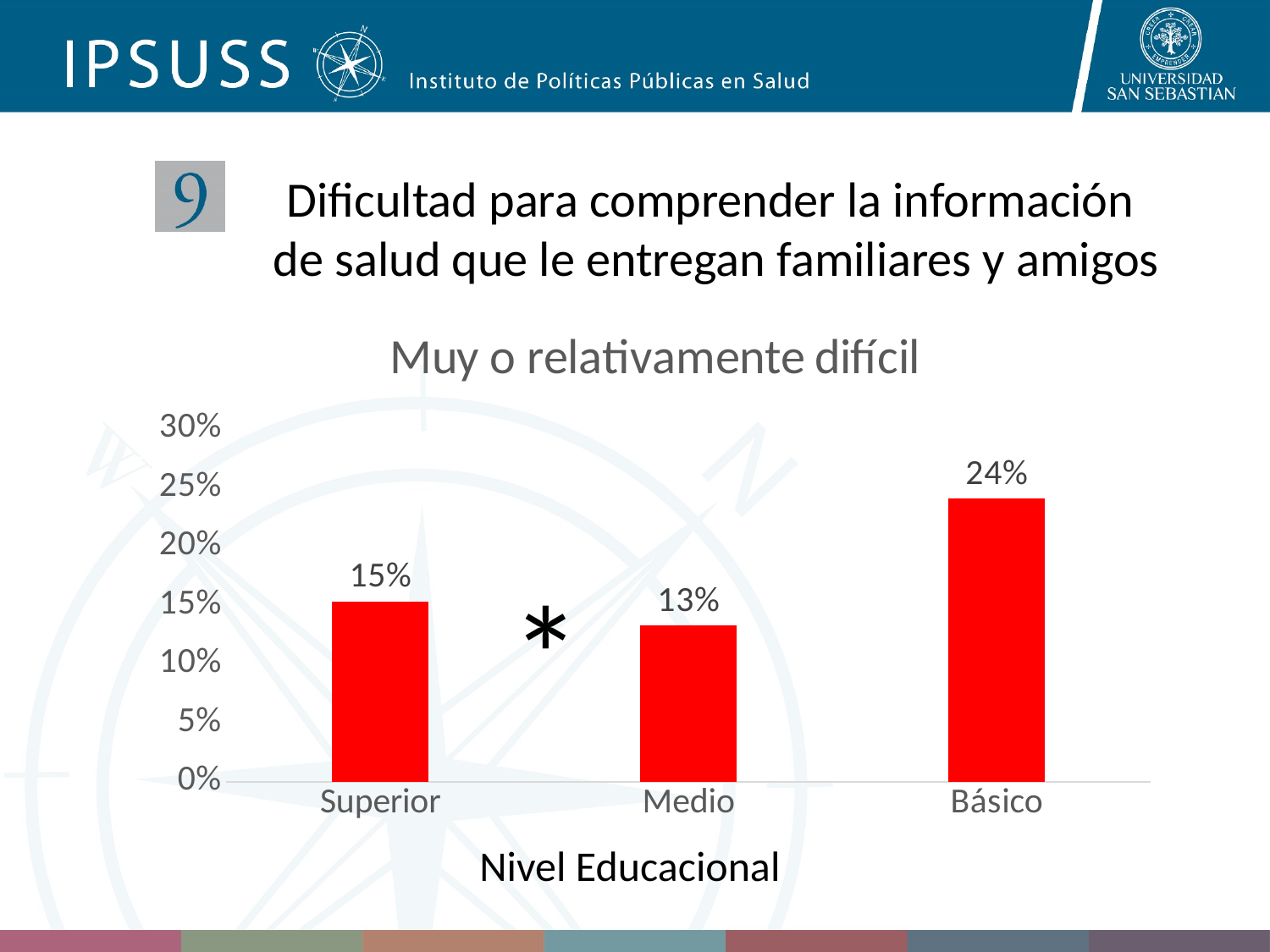
What kind of chart is shown on the slide? bar chart How many educational levels are shown on the x axis? 3 What is the value for Medio? 13% What is the difference between the values for Básico and Medio? 11% Is the value for Básico greater or less than 20%? greater What is the title of the chart? Muy o relativamente difícil What is the difference between the values for Superior and Medio? 2% What is the value for Superior? 15% What is the value for Básico? 24% Which educational level has the lowest value? Medio Which educational level has the highest value? Básico Which is larger, the value for Básico or the value for Superior? Básico